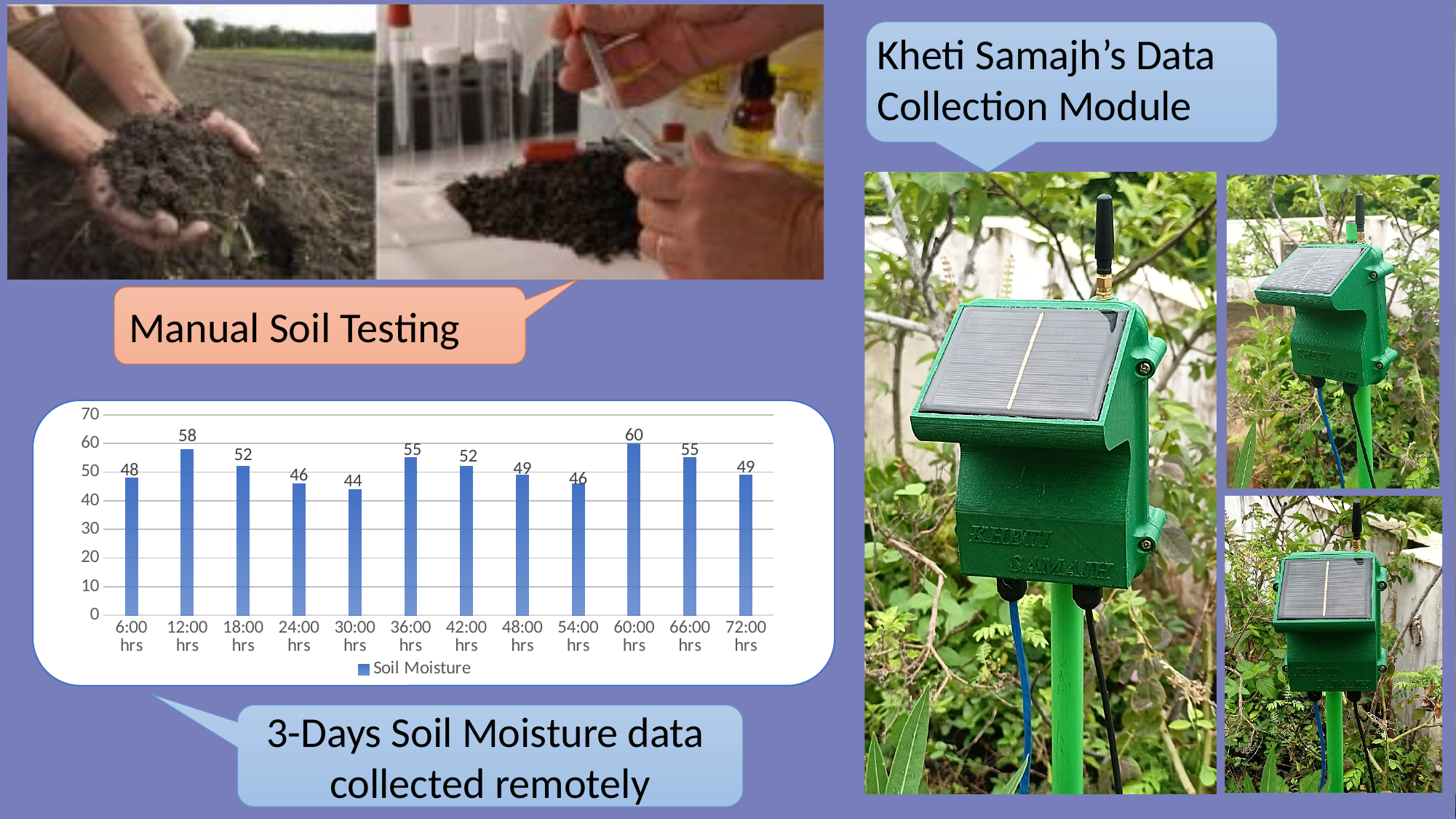
At which time is the soil moisture highest? 60:00 hrs How many time points are plotted in the chart? 12 What kind of chart is shown on the slide? bar chart What is the soil moisture value at 12:00 hrs? 58 Which has a higher soil moisture value, 36:00 hrs or 48:00 hrs? 36:00 hrs How many series does the chart legend list? 1 What is the soil moisture value at 72:00 hrs? 49 At which time is the soil moisture lowest? 30:00 hrs What is the difference between the soil moisture at 60:00 hrs and at 30:00 hrs? 16 What is the soil moisture value at 30:00 hrs? 44 What is the name of the series shown in the chart legend? Soil Moisture Is the soil moisture value at 24:00 hrs greater or less than 50? less